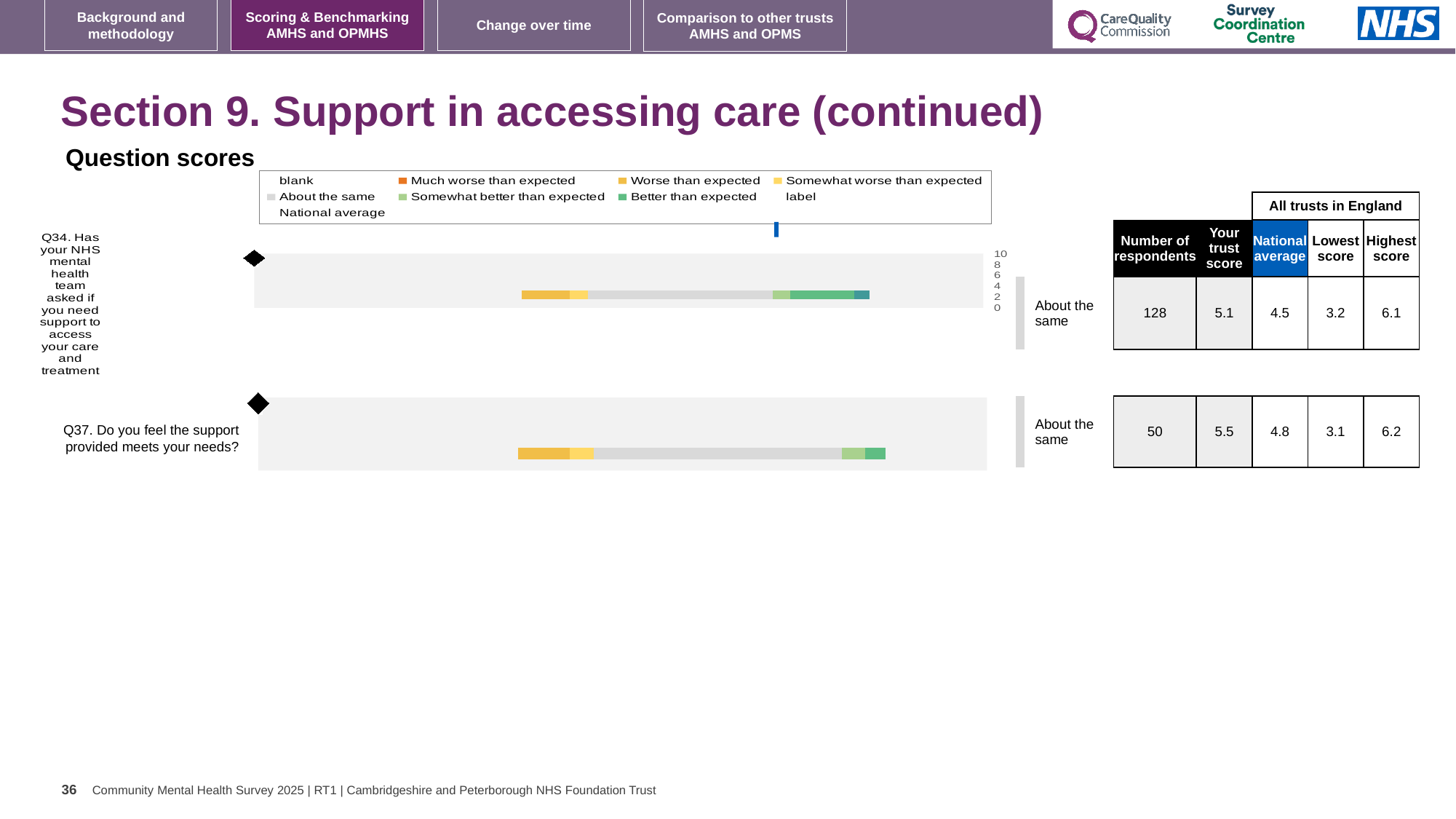
What benchmark category is shown next to the Q34 chart? About the same What is the highest score among all trusts in England for Q37? 6.2 What is the difference between the trust score and the national average for Q37? 0.7 Which legend entry is shown in dark orange in the question scores chart? Much worse than expected What is the number of respondents for Q34? 128 What is the national average score for Q34? 4.5 Which question has the higher trust score, Q34 or Q37? Q37 What is the lowest score among all trusts in England for Q34? 3.2 What is the trust score for Q37 (Do you feel the support provided meets your needs?)? 5.5 What kind of chart is used to show the question scores for Q34 and Q37? bar chart How many questions are plotted in the question scores charts on this slide? 2 What is the difference between the highest and lowest scores for Q34? 2.9